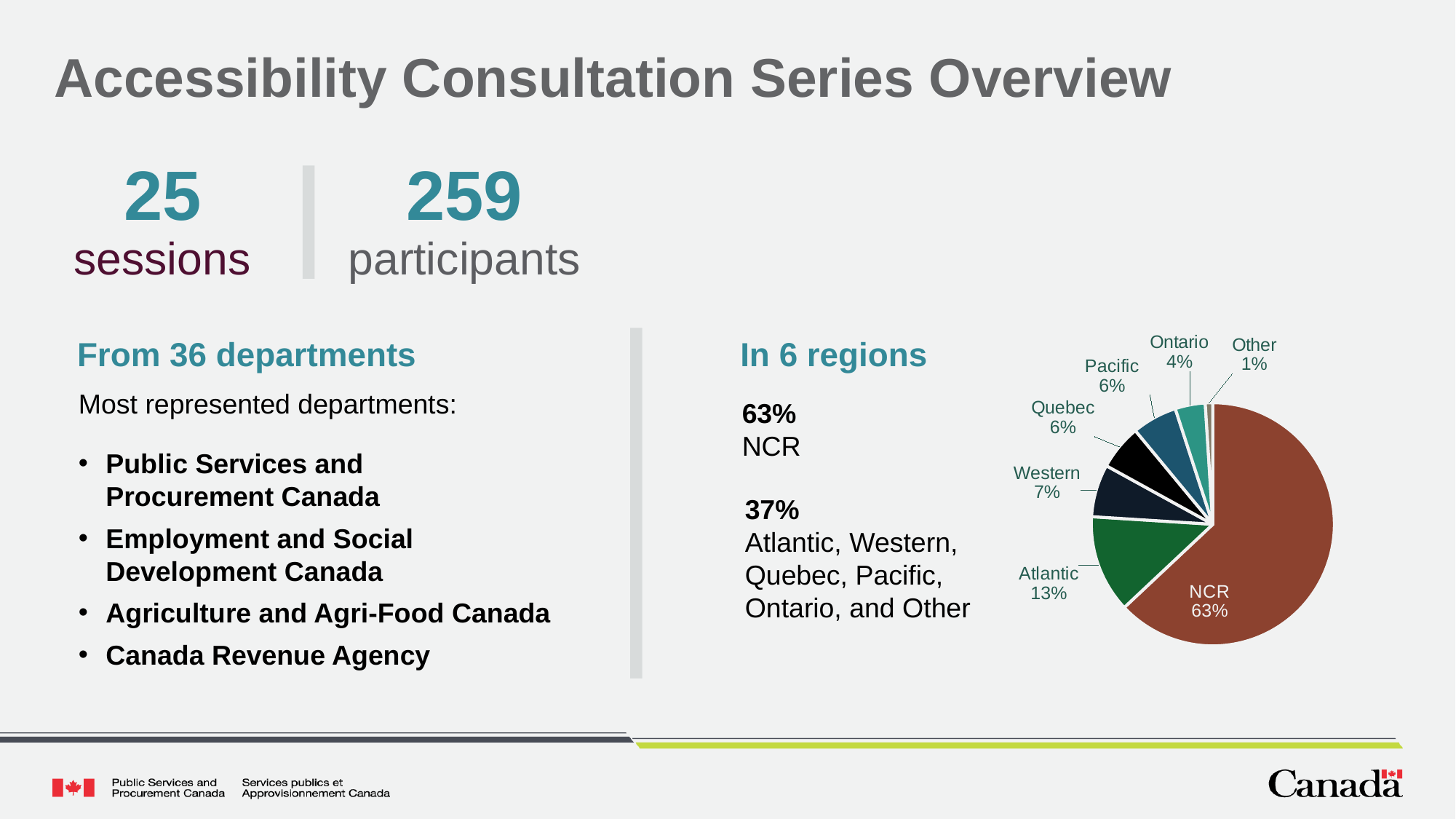
What is the value shown for Atlantic in the pie chart? 13% What is the value shown for Ontario in the pie chart? 4% Which is larger in the pie chart, Western or Ontario? Western What is the difference between the NCR share and the Atlantic share? 50% How many slices does the pie chart have? 7 What is the difference between the Atlantic share and the Pacific share? 7% What colour is the NCR slice of the pie chart? brown What kind of chart is shown on the slide? pie chart Which region has the smallest slice of the pie chart? Other What share of the pie does NCR represent? 63% Which region has the largest slice of the pie chart? NCR What is the value shown for Western in the pie chart? 7%